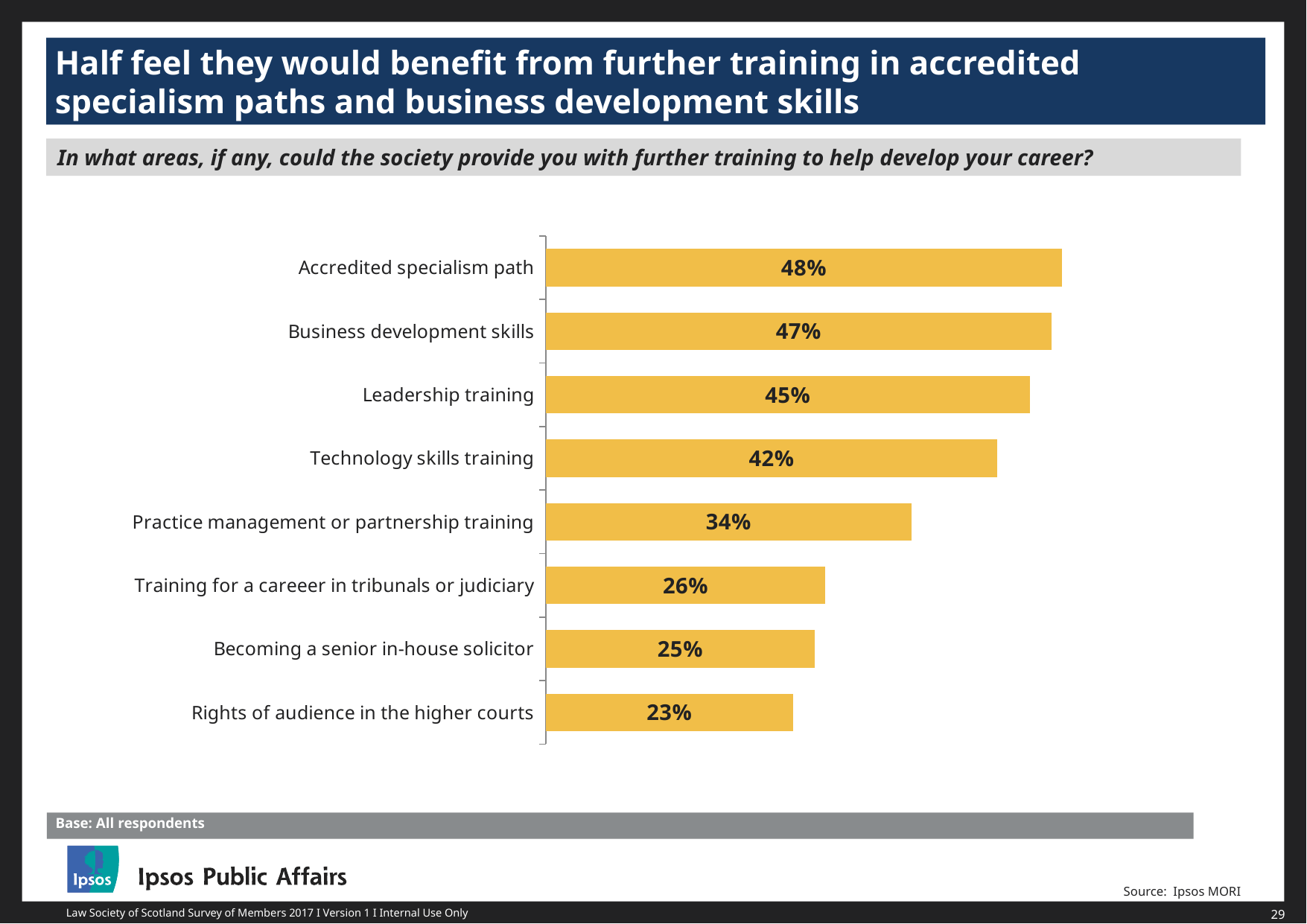
Which has a higher value: Business development skills or Technology skills training? Business development skills What is the difference in percentage points between Accredited specialism path and Rights of audience in the higher courts? 25 What percentage is shown for Becoming a senior in-house solicitor? 25% What is the difference in percentage points between Leadership training and Practice management or partnership training? 11 How many training areas are shown in the chart? 8 What colour are the bars in the chart? Yellow Which training area has the lowest percentage? Rights of audience in the higher courts Which has a higher value: Training for a careeer in tribunals or judiciary or Practice management or partnership training? Practice management or partnership training What type of chart is shown on the slide? Bar chart Which training area has the highest percentage? Accredited specialism path What is the value shown for Technology skills training? 42% What percentage of respondents said the society could provide further training in an accredited specialism path? 48%